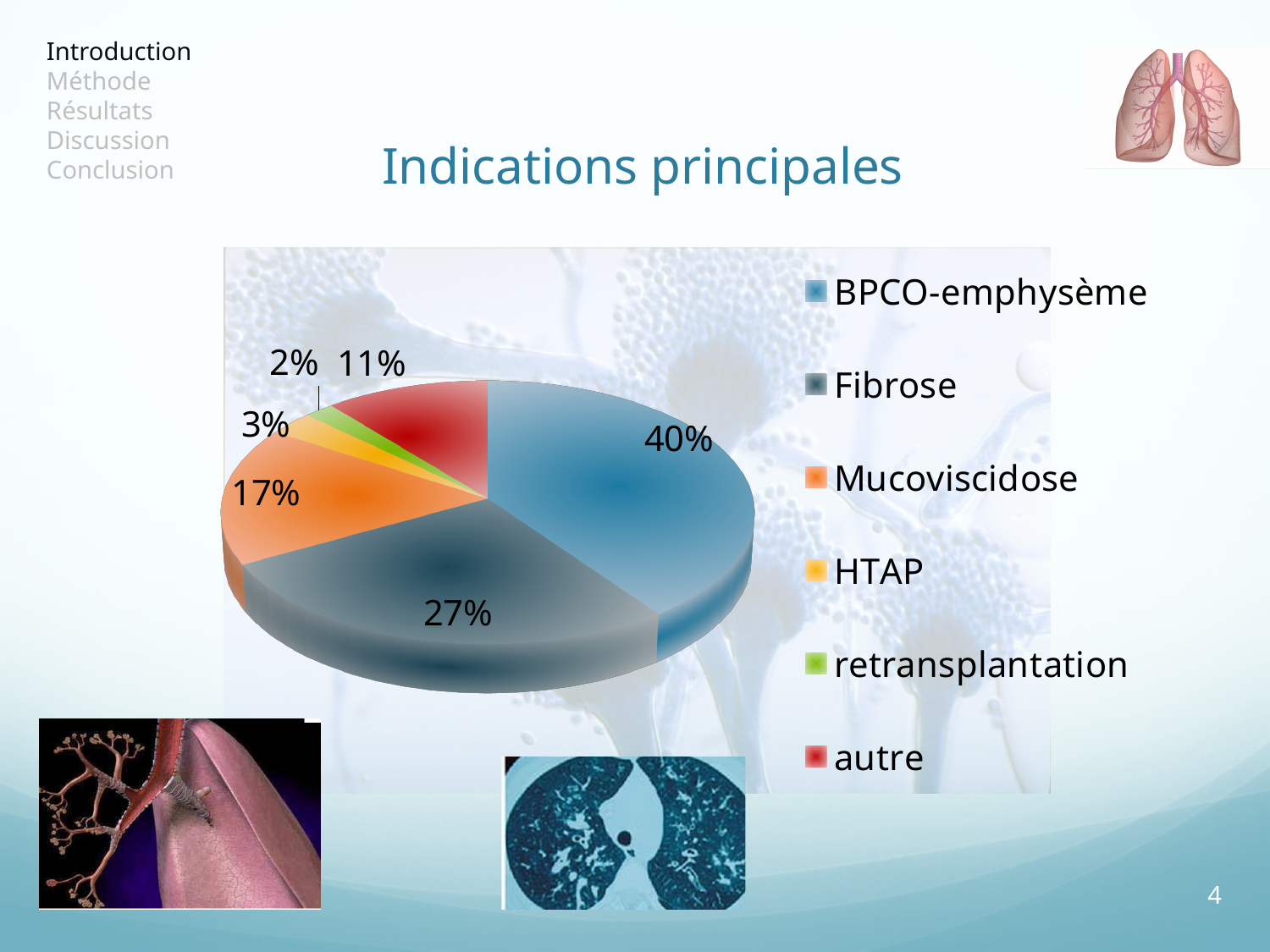
What share of the pie does retransplantation represent? 2% What share of the pie does Fibrose represent? 27% Which category has the largest slice of the pie? BPCO-emphysème What is the difference in percentage points between BPCO-emphysème and Fibrose? 13 What share of the pie does BPCO-emphysème represent? 40% How many categories does the legend list? 6 What kind of chart is shown on the slide? pie chart Which is larger, the share for Mucoviscidose or the share for autre? Mucoviscidose Which category has the smallest slice of the pie? retransplantation